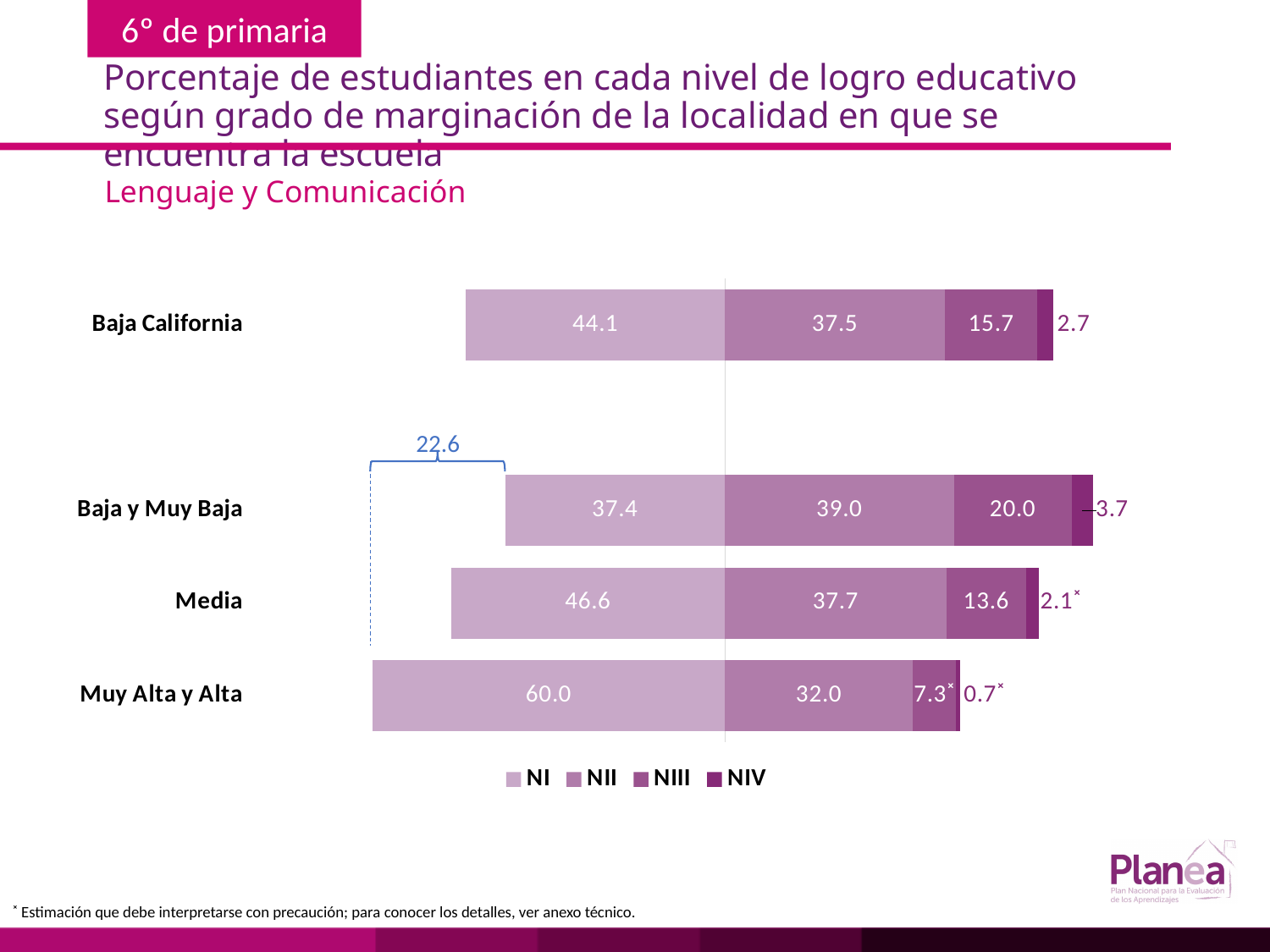
What is the NIV value for Media? 2.1 What is the NI value for Muy Alta y Alta? 60.0 What is the NIII value for Baja California? 15.7 How many categories are shown on the chart? 4 Which is larger, the NI value for Media or for Baja y Muy Baja? Media What kind of chart is shown on the slide? Stacked bar chart Which category has the lowest NI value? Baja y Muy Baja Which category has the highest NI value? Muy Alta y Alta What is the difference between the NI values for Muy Alta y Alta and Media? 13.4 What is the total of the stacked bar for Baja California? 100.0 What is the NII value for Baja y Muy Baja? 39.0 How many series does the legend list? 4